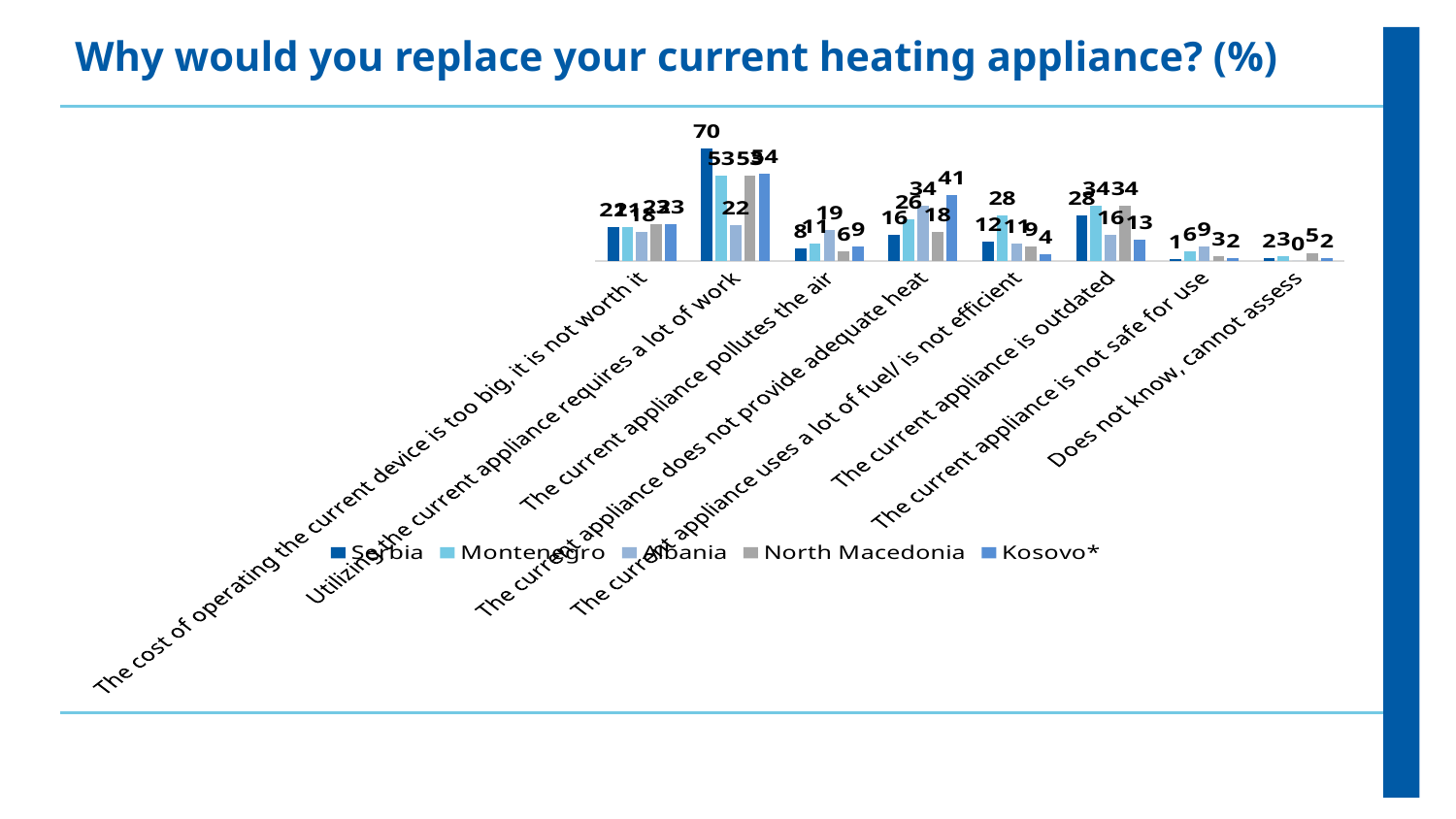
What is the value for Kosovo* for 'The current appliance does not provide adequate heat'? 41 What is the value for Albania for 'The current appliance pollutes the air'? 19 What is the value for Montenegro for 'The current appliance is outdated'? 34 Which series is listed first in the legend? Serbia What is the value for Serbia for 'Utilizing the current appliance requires a lot of work'? 70 Which country has the lowest value for 'The current appliance uses a lot of fuel/ is not efficient'? Kosovo* How many series does the legend list? 5 Which country has the highest value for 'The current appliance does not provide adequate heat'? Kosovo* For 'The current appliance uses a lot of fuel/ is not efficient', which is larger: Montenegro or Kosovo*? Montenegro How many reason categories are shown along the x axis? 8 What is the difference between Kosovo* and Serbia for 'The current appliance does not provide adequate heat'? 25 What kind of chart is shown on the slide? Bar chart